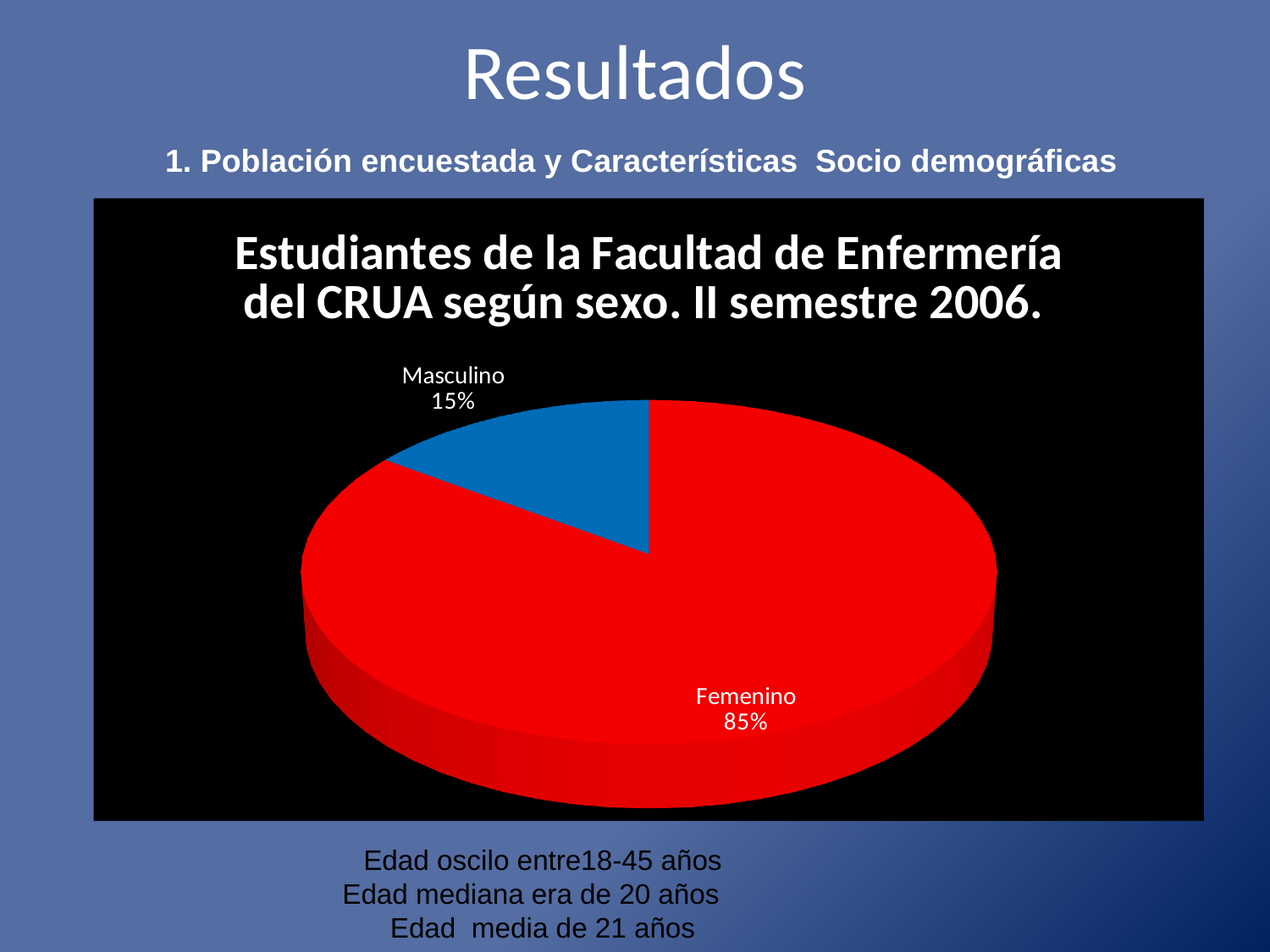
What is the title of the chart? Estudiantes de la Facultad de Enfermería del CRUA según sexo. II semestre 2006. What is the difference in percentage points between Femenino and Masculino? 70 How many slices does the pie chart have? 2 Which category has the largest share of the pie? Femenino What kind of chart is shown on the slide? Pie chart Which category has the smallest share of the pie? Masculino What is the combined share of the Femenino and Masculino slices? 100% What percentage of the pie is Femenino? 85% What colour is the Femenino slice? Red What percentage of the pie is Masculino? 15% Which is larger, the Femenino slice or the Masculino slice? Femenino